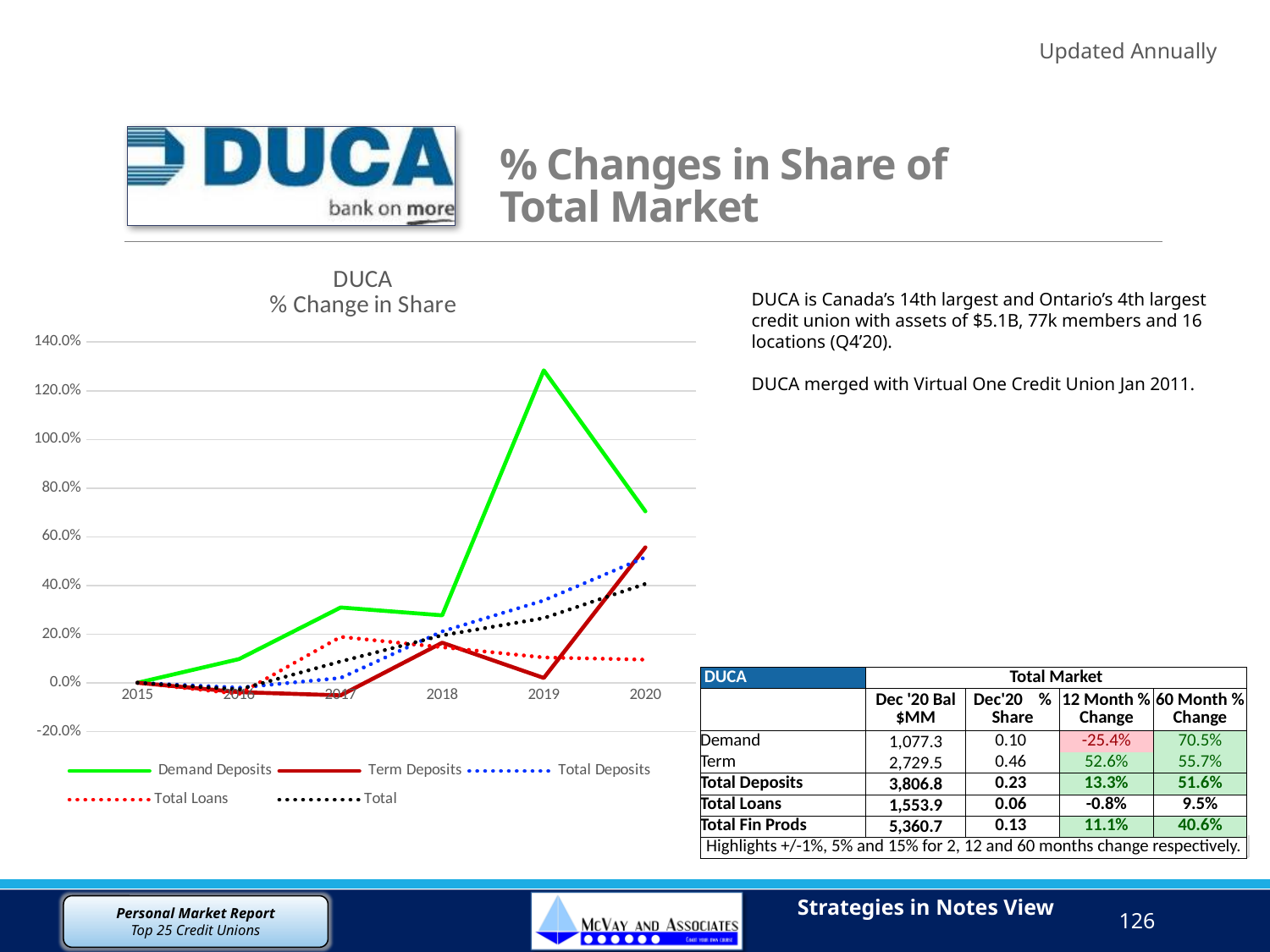
In 2020, which is larger: Demand Deposits or Term Deposits? Demand Deposits How many years are plotted along the x axis of the chart? 6 What is the title of the chart? DUCA % Change in Share Is the value for Total Loans in 2020 greater or less than 20.0%? less Which series has the highest value in 2019? Demand Deposits How many series does the chart legend list? 5 What kind of chart is shown on the slide? line chart Is the value for Demand Deposits in 2019 greater or less than 100.0%? greater Is the value for Term Deposits in 2019 greater or less than 20.0%? less In which year does the Demand Deposits series reach its highest value? 2019 Does the Demand Deposits series rise or fall from 2019 to 2020? fall Which series has the lowest value in 2019? Term Deposits